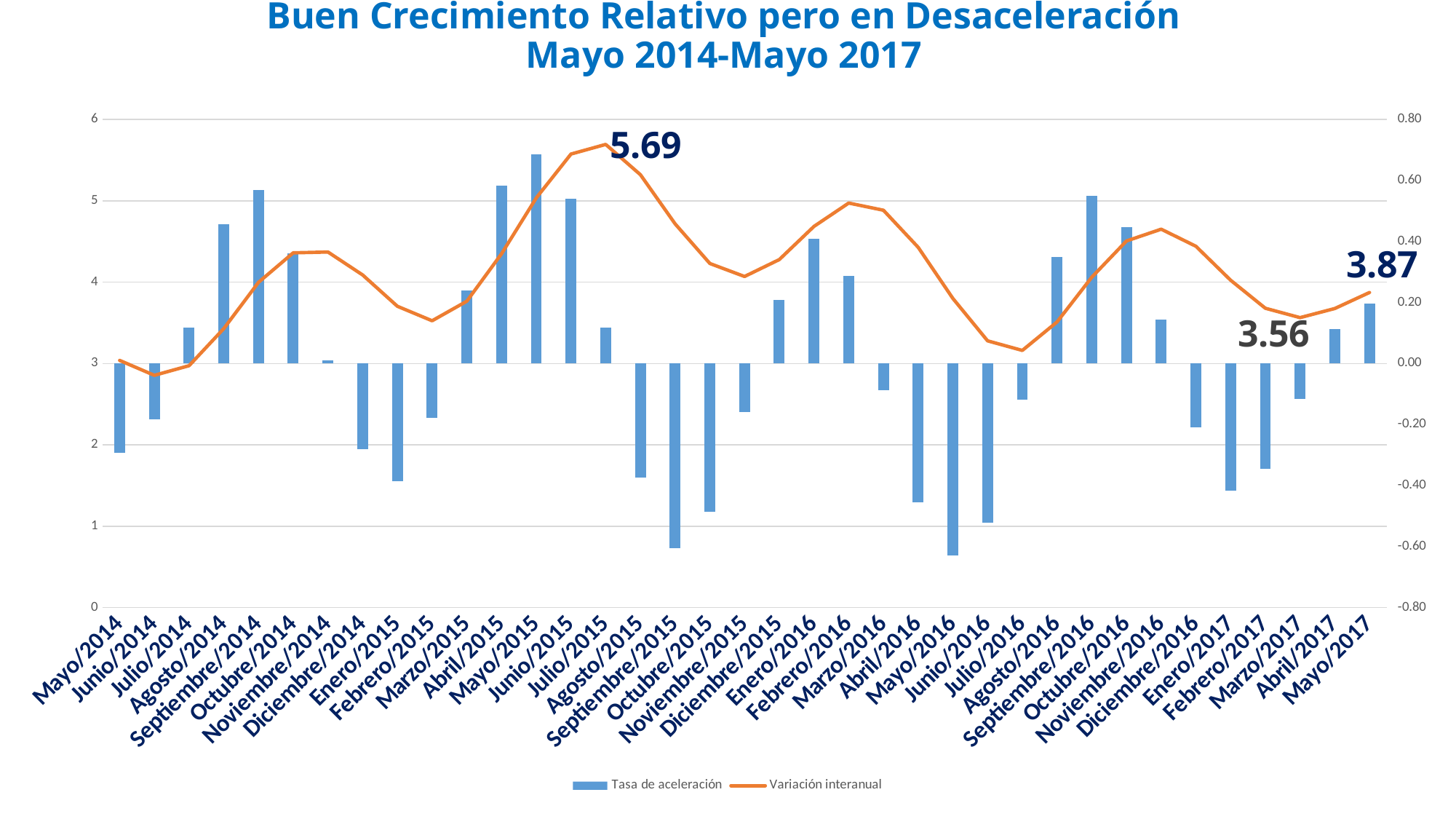
What is the difference between the Variación interanual values labelled 5.69 and 3.87? 1.82 In which month does the Variación interanual line reach its highest point? Julio/2015 How many months are shown on the x axis? 37 What is the labelled value of Variación interanual at Julio/2015? 5.69 Which month has the tallest positive Tasa de aceleración bar? Mayo/2015 How many series does the legend list? 2 What kind of chart is shown on the slide? A combination bar and line chart Is the Variación interanual value for Octubre/2015 greater or less than 4? greater What is the labelled value of Variación interanual at Marzo/2017? 3.56 Does the Variación interanual line rise or fall from Julio/2015 to Noviembre/2015? Falls What are the two series named in the legend? Tasa de aceleración and Variación interanual What is the labelled value of Variación interanual at Mayo/2017? 3.87